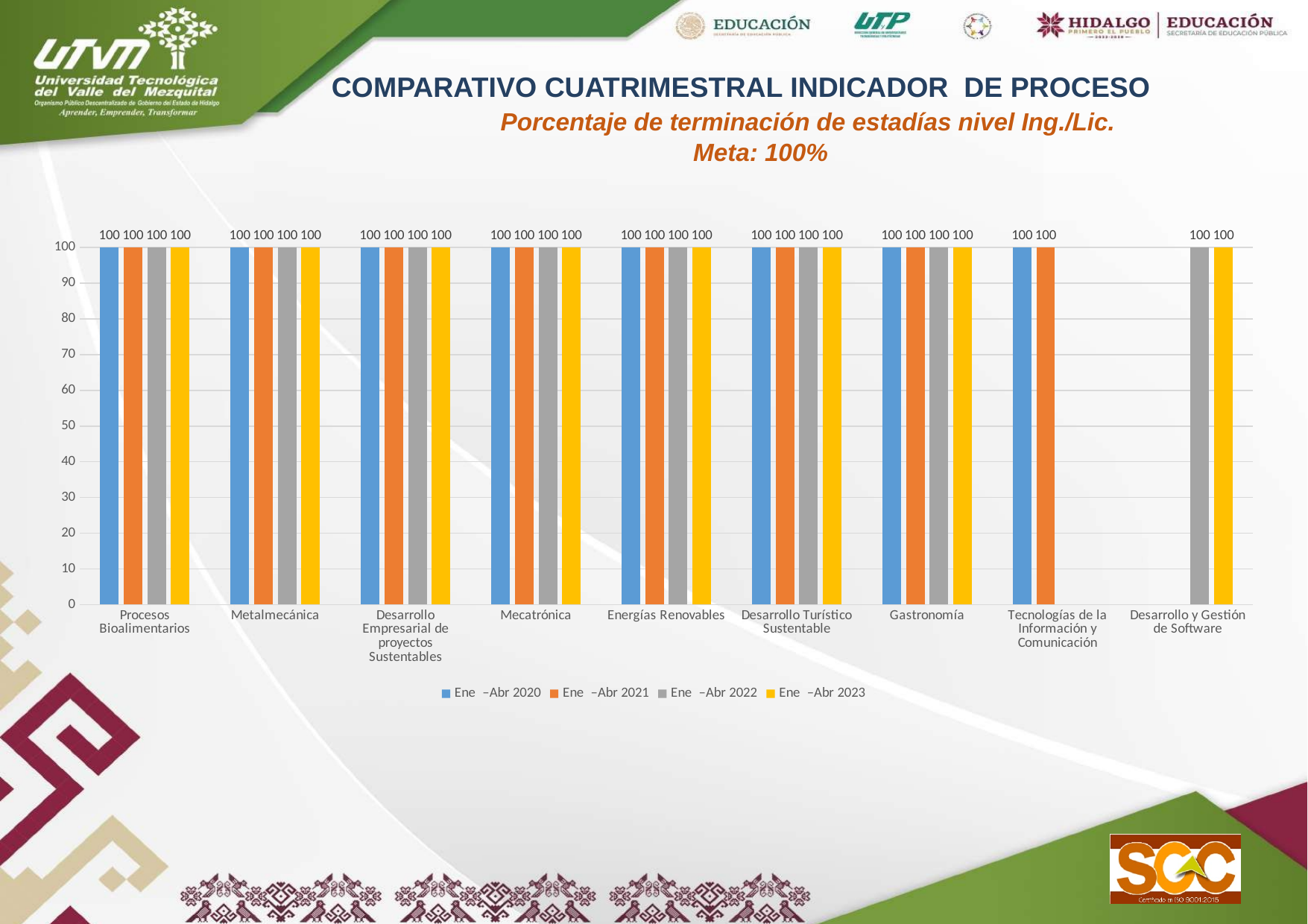
What is the value for Gastronomía in the Ene –Abr 2020 series? 100 What is the value for Mecatrónica in the Ene –Abr 2022 series? 100 What is the target (Meta) stated in the chart subtitle? 100% What is the difference between the Ene –Abr 2020 and Ene –Abr 2023 values for Metalmecánica? 0 Is the value for Energías Renovables in the Ene –Abr 2022 series greater or less than 90? greater What is the value for Desarrollo y Gestión de Software in the Ene –Abr 2023 series? 100 Which series is shown in yellow in the legend? Ene –Abr 2023 What kind of chart is shown on the slide? bar chart What is the value for Tecnologías de la Información y Comunicación in the Ene –Abr 2021 series? 100 Do the values for the Ene –Abr 2021 series rise, fall, or stay the same across the categories? stay the same How many categories are shown on the x axis of the chart? 9 How many series does the legend list? 4